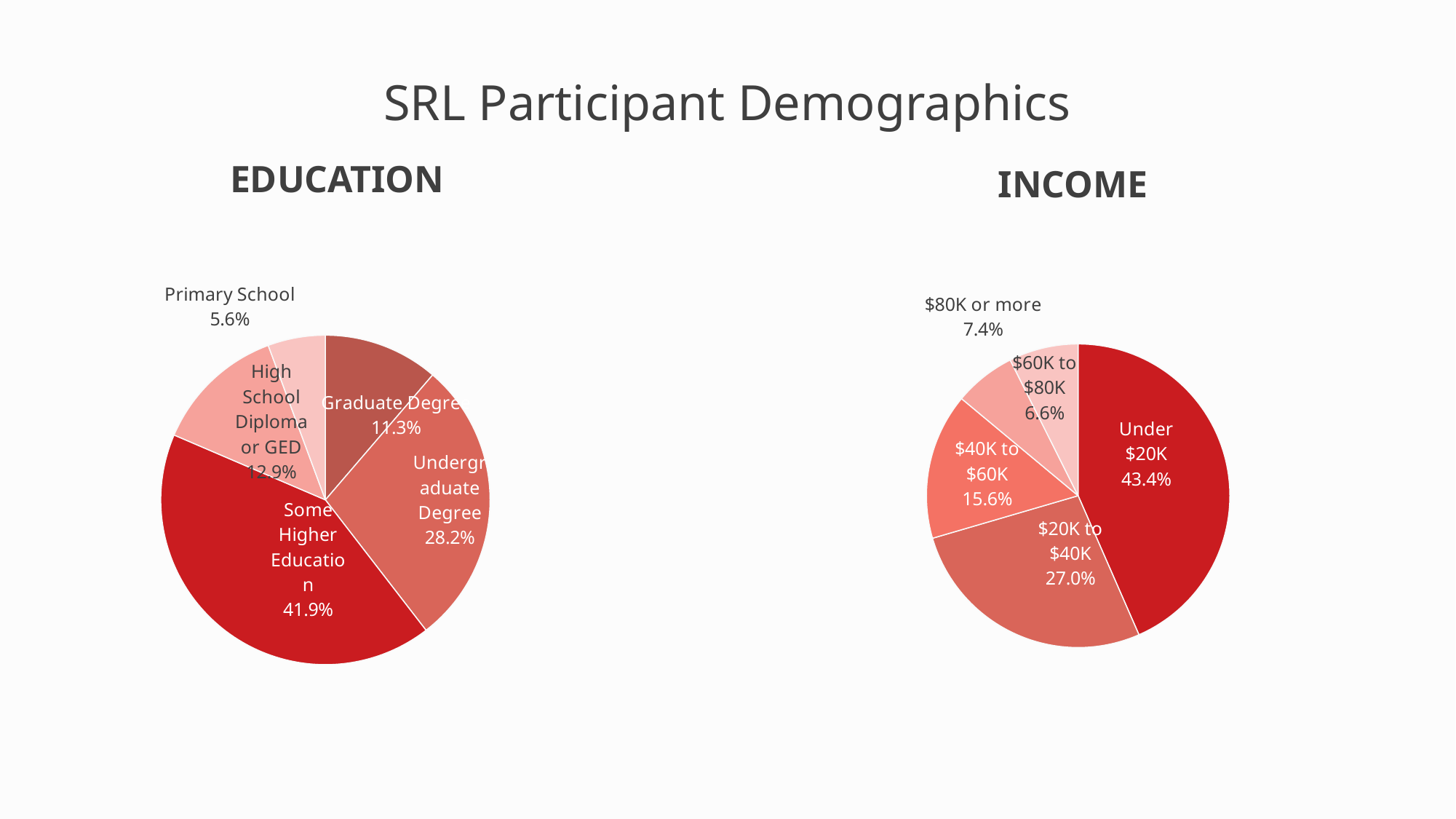
In the EDUCATION chart, which category has the largest share? Some Higher Education In the INCOME chart, which income bracket has the smallest share? $60K to $80K In the EDUCATION chart, which category has the smallest share? Primary School In the EDUCATION chart, what share of participants have an Undergraduate Degree? 28.2% In the EDUCATION chart, what is the difference between the Some Higher Education share and the Undergraduate Degree share? 13.7% In the INCOME chart, which income bracket has the largest share? Under $20K What is the title of the slide containing the two charts? SRL Participant Demographics In the EDUCATION chart, how many categories are shown? 5 In the INCOME chart, what is the difference between the Under $20K share and the $20K to $40K share? 16.4% In the INCOME chart, what share of participants earn $40K to $60K? 15.6% In the INCOME chart, which is larger: the share for $20K to $40K or the share for $40K to $60K? $20K to $40K What kind of chart is the INCOME chart? Pie chart